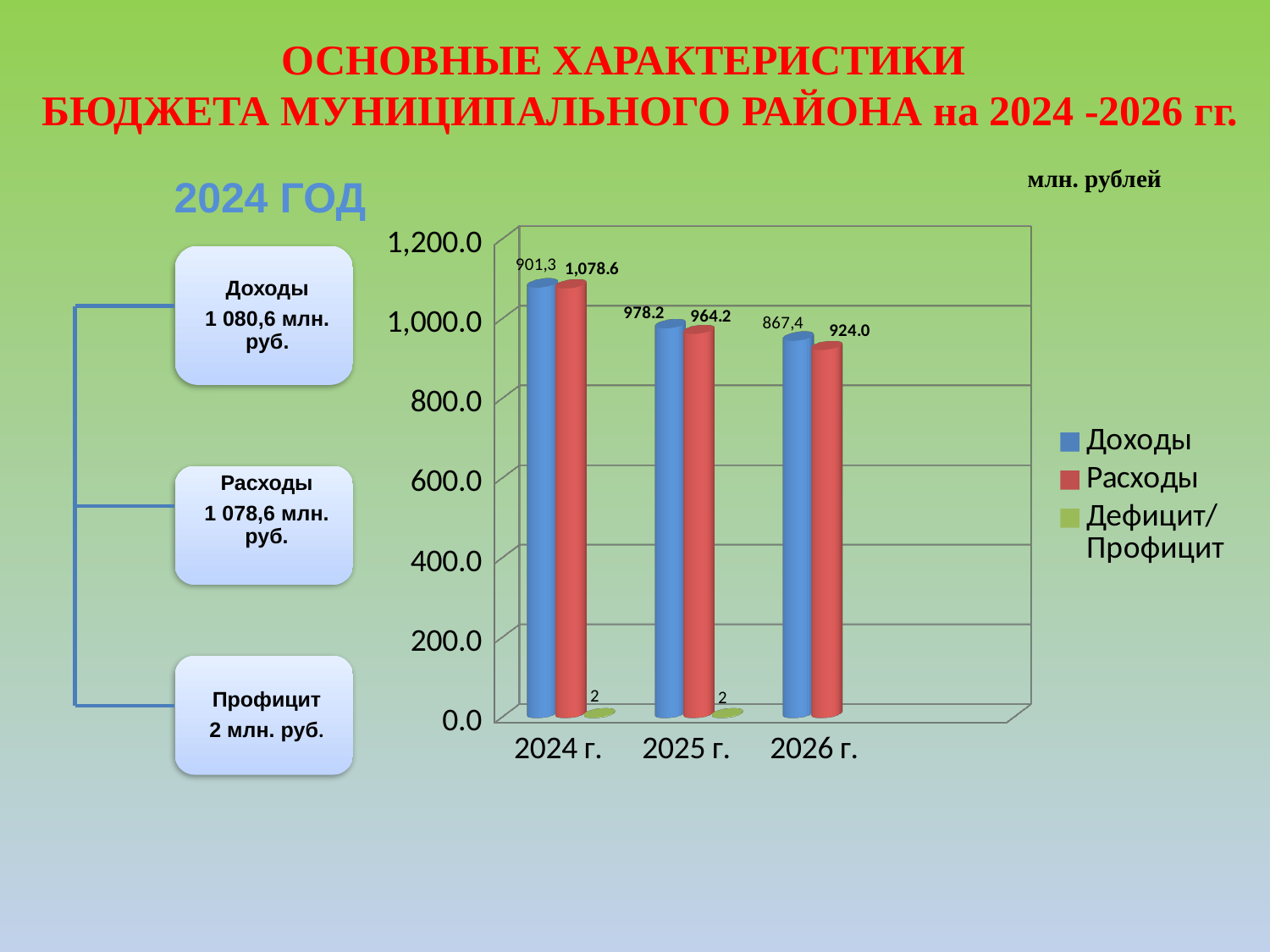
What is the difference between Доходы and Расходы in 2025 г.? 14.0 In which year is Расходы the highest? 2024 г. How many year categories are shown on the x axis of the chart? 3 What is the value of Доходы for 2025 г.? 978.2 What is the value of Расходы for 2024 г.? 1,078.6 Is the value of Расходы for 2024 г. greater or less than 1,000.0? greater How many series does the chart legend list? 3 What is the value of Дефицит/Профицит for 2025 г.? 2 Do the Расходы values rise or fall from 2024 г. to 2026 г.? fall In which year is Расходы the lowest? 2026 г. What is the value of Расходы for 2026 г.? 924.0 What type of chart is shown on the slide? bar chart